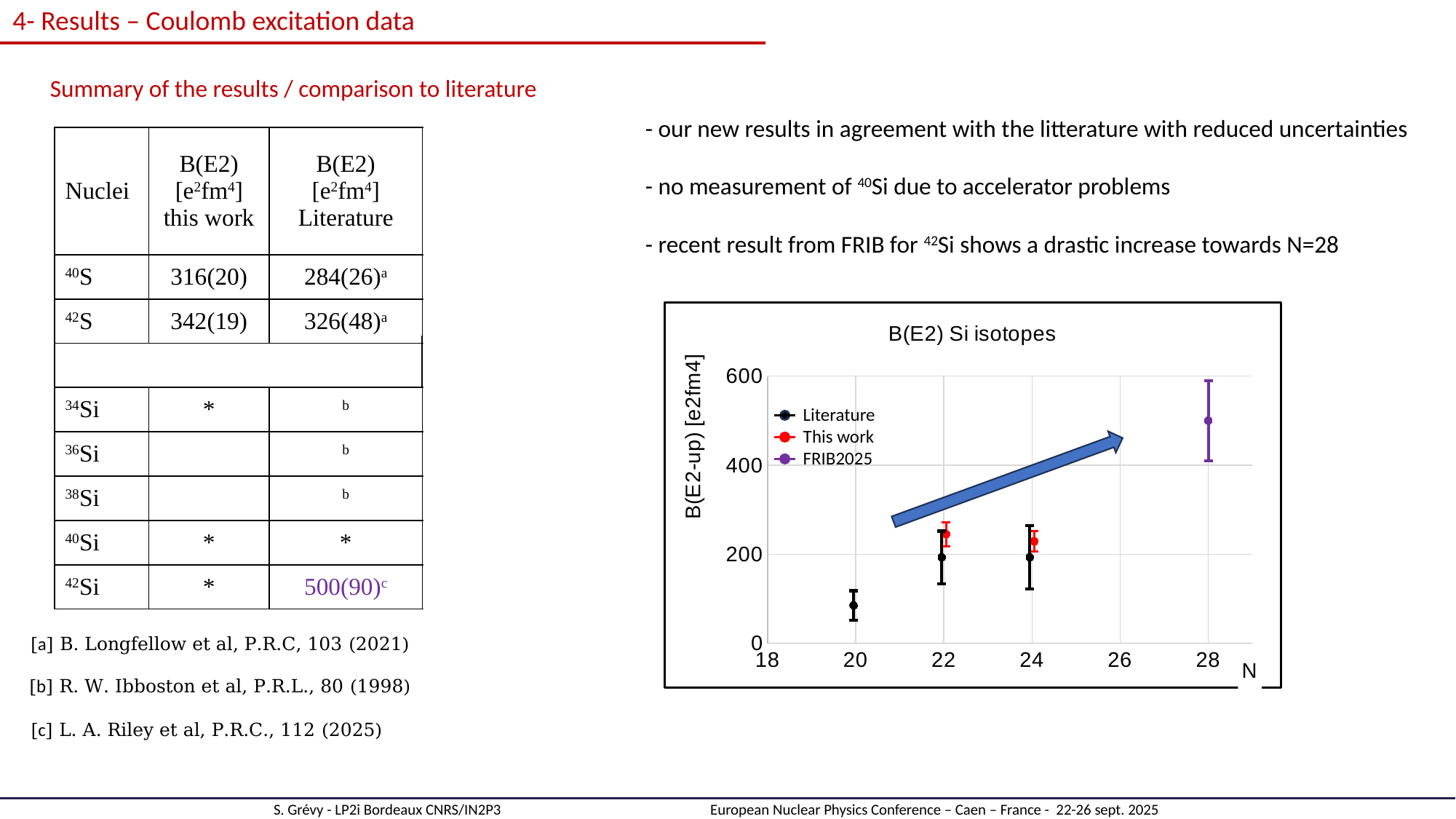
Which series has the highest plotted point in the chart? FRIB2025 What is the title of the chart? B(E2) Si isotopes At N=22, which is larger: the Literature value or the 'This work' value? This work What colour is used for the 'This work' series in the chart? Red How many data points are plotted for the Literature series? 3 Does the Literature series rise or fall from N=20 to N=22? Rise Is the Literature value at N=20 greater or less than 200? less Is the FRIB2025 value at N=28 greater or less than 400? greater How many series does the legend of the B(E2) Si isotopes chart list? 3 At which N does the Literature series have its lowest value? 20 What kind of chart is shown on the slide? Scatter chart with error bars Is the 'This work' value at N=22 greater or less than 200? greater